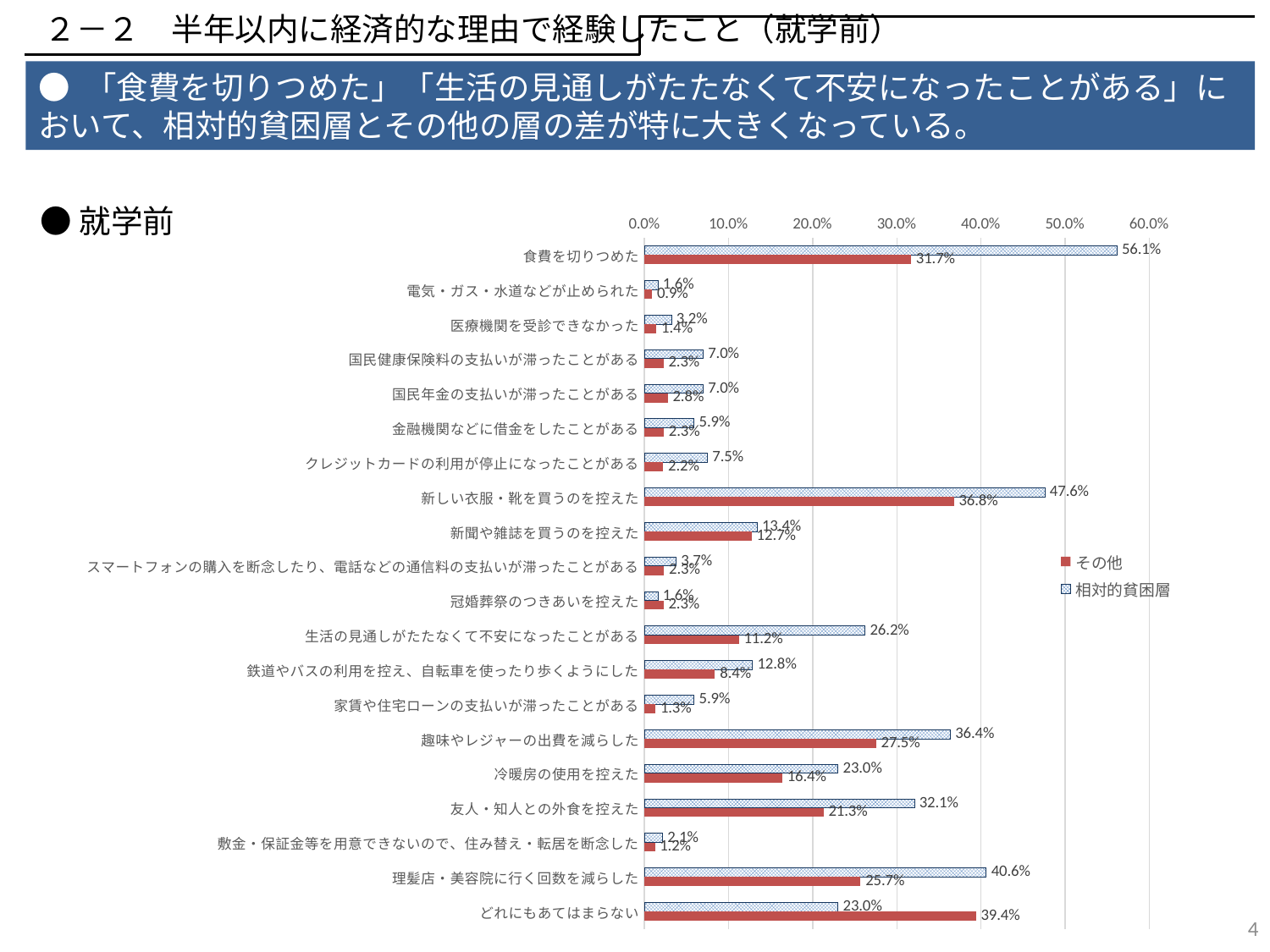
What is the value for その他 in the category 生活の見通しがたたなくて不安になったことがある? 11.2% What is the difference between 相対的貧困層 and その他 in the category 食費を切りつめた? 24.4% In the category どれにもあてはまらない, which series has the larger value, 相対的貧困層 or その他? その他 Which category has the highest value for 相対的貧困層? 食費を切りつめた What is the value for 相対的貧困層 in the category 理髪店・美容院に行く回数を減らした? 40.6% In the category 冠婚葬祭のつきあいを控えた, which series has the larger value, 相対的貧困層 or その他? その他 What is the value for 相対的貧困層 in the category 食費を切りつめた? 56.1% How many categories are shown on the chart? 20 What is the difference between 相対的貧困層 and その他 in the category 生活の見通しがたたなくて不安になったことがある? 15.0% Which category has the highest value for その他? どれにもあてはまらない How many series does the legend list? 2 What kind of chart is shown on the slide? Bar chart